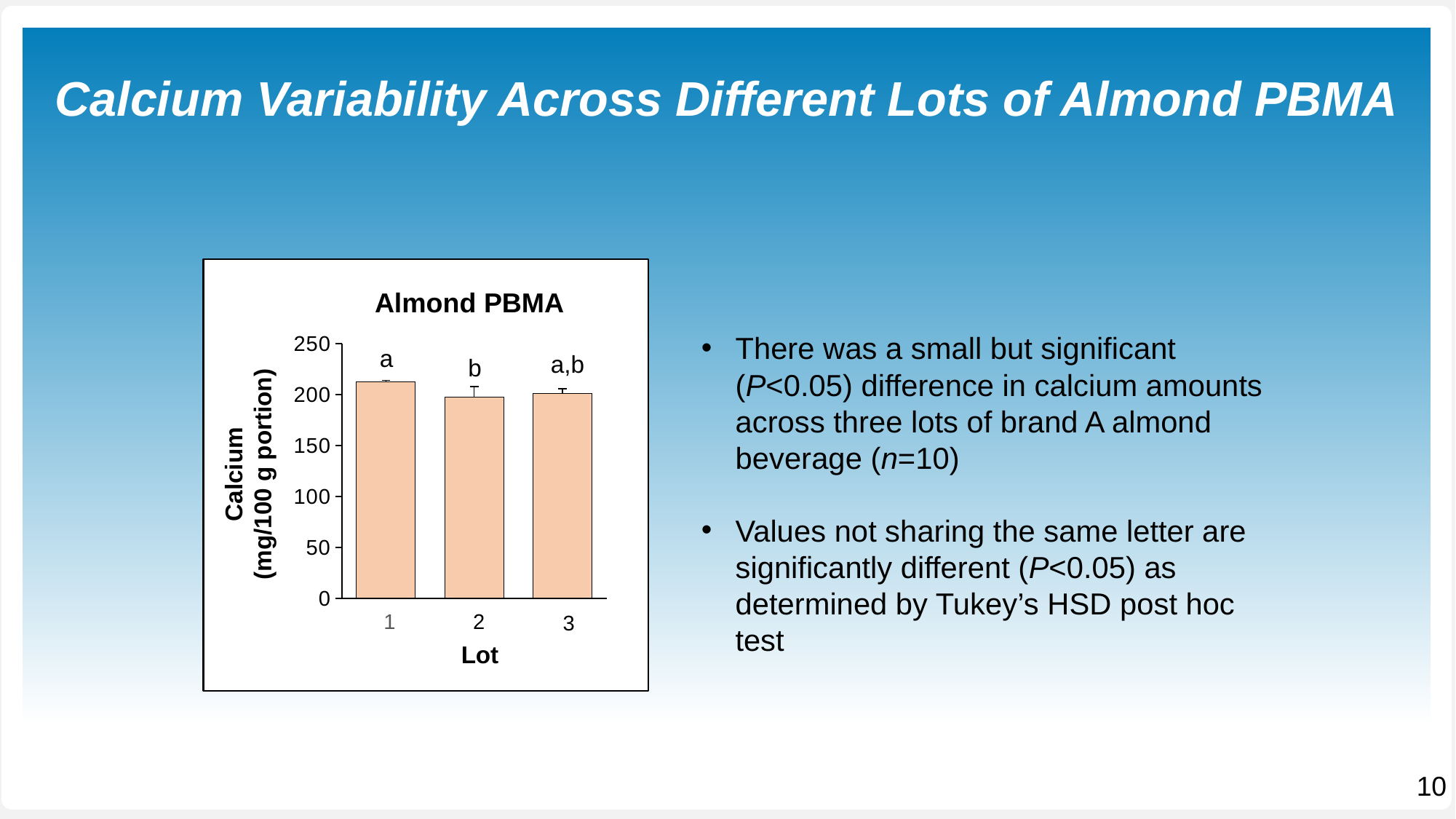
What is the title of the chart? Almond PBMA Which lot has the highest calcium value in the Almond PBMA chart? Lot 1 Is the calcium value for Lot 1 greater or less than 200? greater Which has a larger calcium value, Lot 1 or Lot 2? Lot 1 Is the calcium value for Lot 3 greater or less than 250? less What letter label appears above the bar for Lot 3? a,b How many lots are plotted in the Almond PBMA chart? 3 Is the calcium value for Lot 2 greater or less than 150? greater What kind of chart is shown on the slide? bar chart